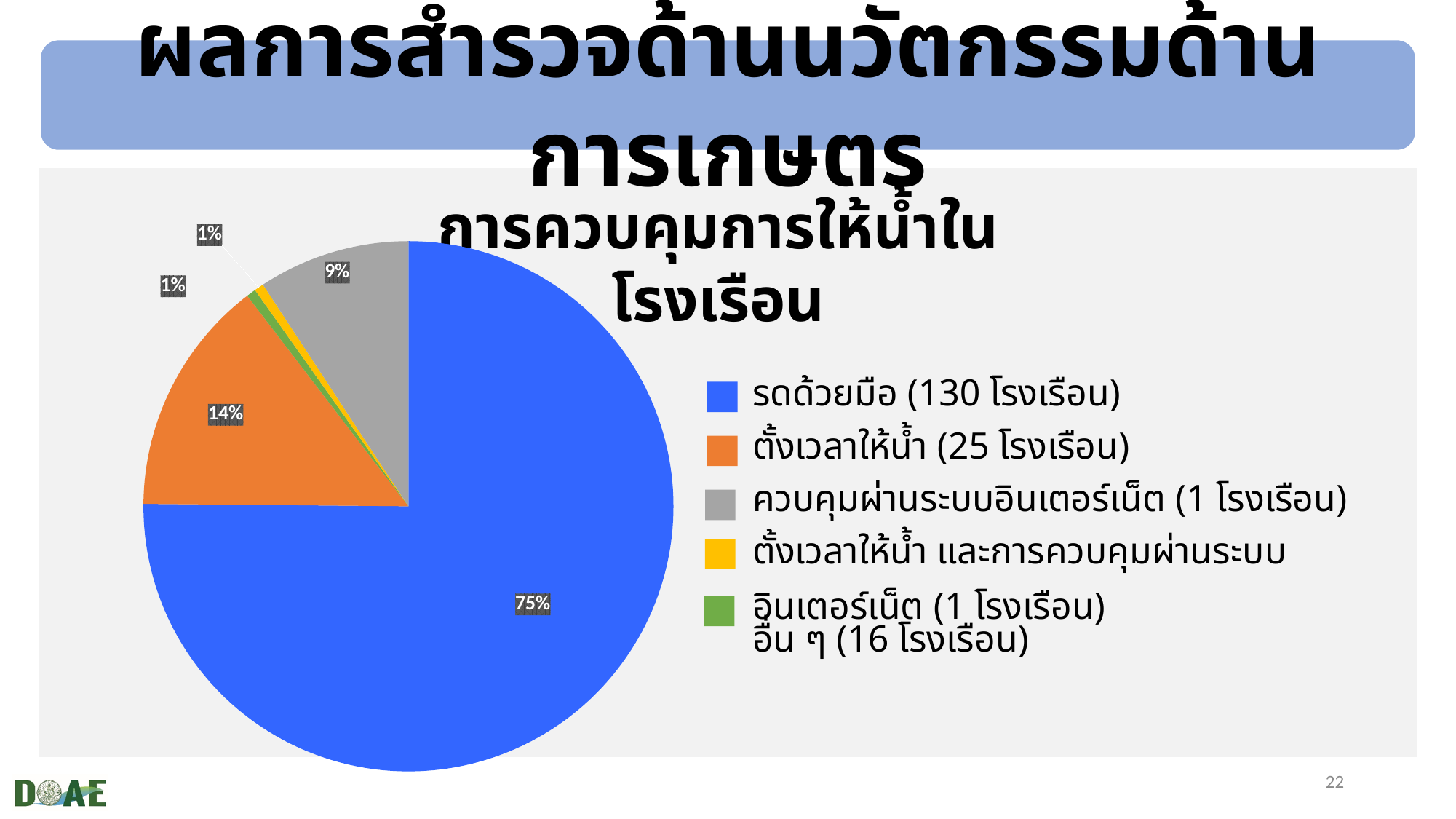
What percentage is shown on the gray slice? 9% What percentage is shown for the รดด้วยมือ slice? 75% What percentage is shown for the ตั้งเวลาให้น้ำ slice? 14% How many slices does the pie chart have? 5 What kind of chart is shown on the slide? pie chart Which is larger, the รดด้วยมือ slice or the ตั้งเวลาให้น้ำ slice? รดด้วยมือ What is the chart's title? การควบคุมการให้น้ำในโรงเรือน Which category has the largest slice of the pie? รดด้วยมือ What colour is the รดด้วยมือ slice? blue According to the legend, how many greenhouses are in the รดด้วยมือ category? 130 โรงเรือน What is the difference in percentage points between the รดด้วยมือ slice and the ตั้งเวลาให้น้ำ slice? 61% How many entries does the legend list? 5